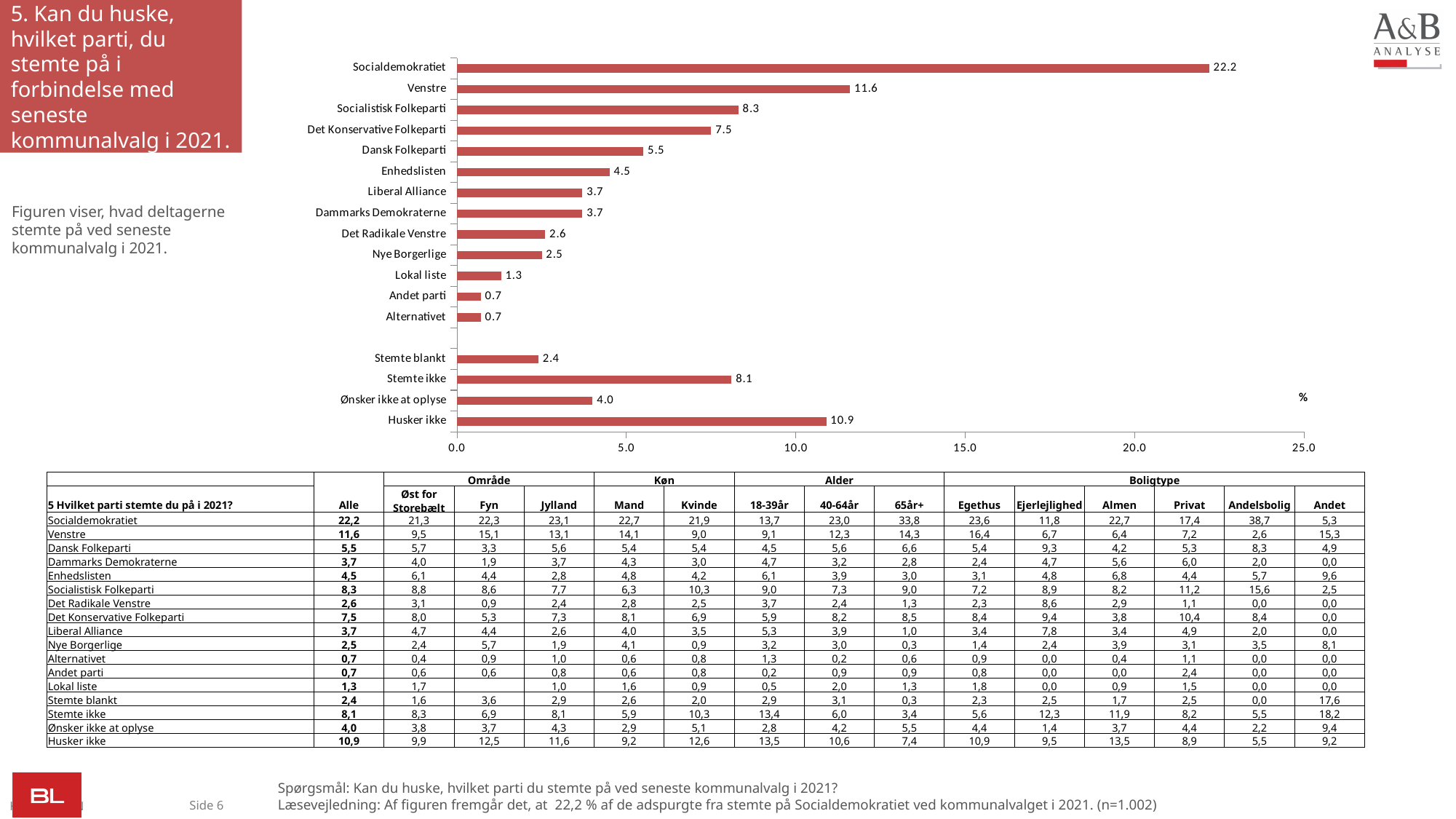
How many bars are plotted in the bar chart? 17 What value is shown for Enhedslisten in the bar chart? 4.5 What is the difference between the values for Venstre and Socialistisk Folkeparti in the bar chart? 3.3 What is the maximum value shown on the x axis of the bar chart? 25.0 Is the value for Venstre in the bar chart greater or less than 10.0? greater Which category has the highest value in the bar chart? Socialdemokratiet What kind of chart is shown on the slide? Bar chart What value is shown for Stemte blankt in the bar chart? 2.4 Which is larger in the bar chart, the value for Stemte ikke or the value for Det Konservative Folkeparti? Stemte ikke What value is shown for Socialdemokratiet in the bar chart? 22.2 What value is shown for Husker ikke in the bar chart? 10.9 What is the difference between the values for Socialdemokratiet and Husker ikke in the bar chart? 11.3